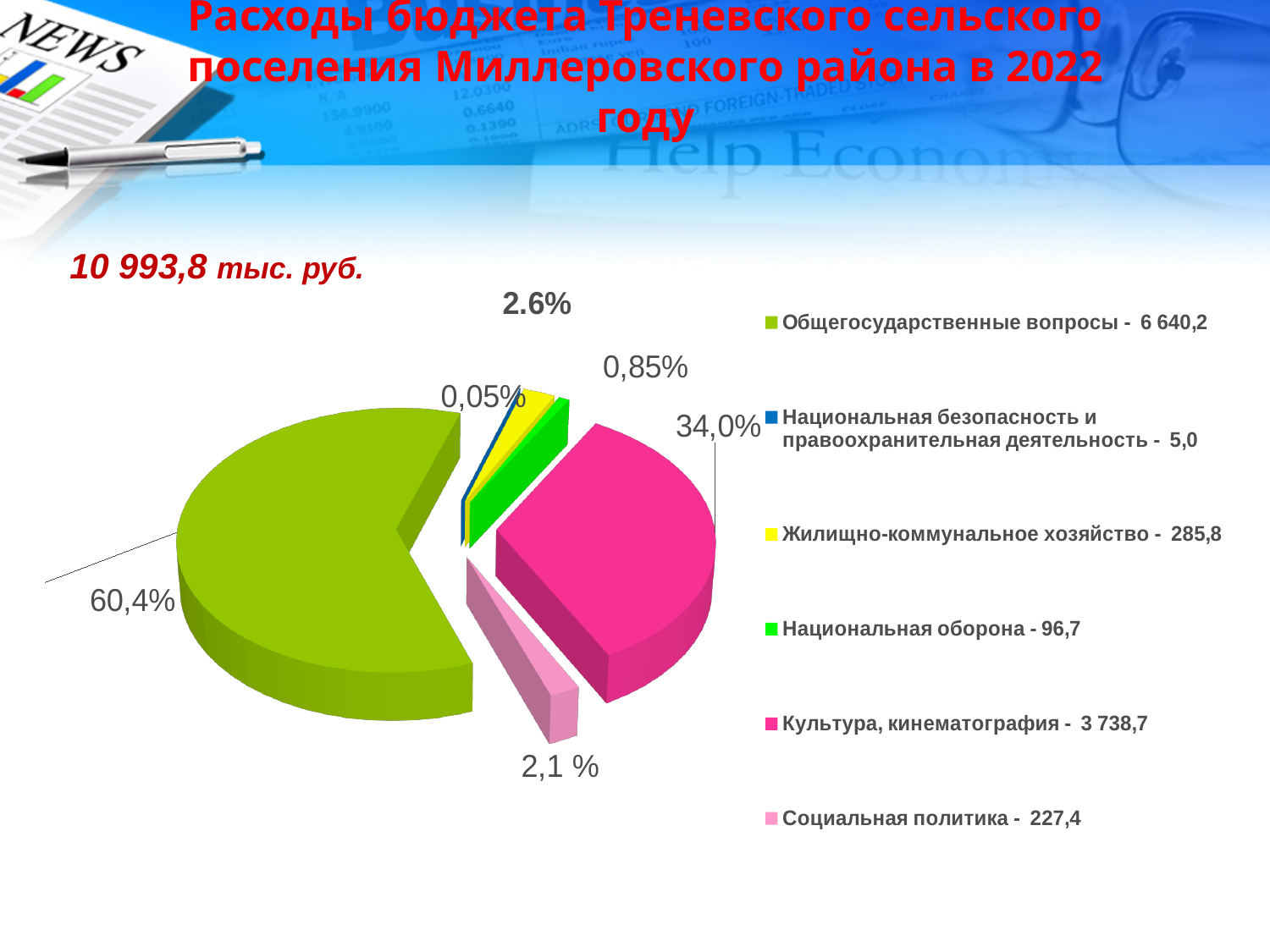
Which is larger: Социальная политика or Жилищно-коммунальное хозяйство? Жилищно-коммунальное хозяйство How many categories does the legend of the pie chart list? 6 What is the value shown in the legend for Национальная оборона? 96,7 Which category has the smallest slice of the pie? Национальная безопасность и правоохранительная деятельность What share of the pie does Общегосударственные вопросы take? 60,4% What share of the pie does Культура, кинематография take? 34,0% What is the value shown in the legend for Жилищно-коммунальное хозяйство? 285,8 Which category has the largest slice of the pie? Общегосударственные вопросы What is the value shown in the legend for Культура, кинематография? 3 738,7 What is the difference between the legend values for Общегосударственные вопросы and Культура, кинематография? 2 901,5 What kind of chart is shown on the slide? pie chart What is the value shown in the legend for Общегосударственные вопросы? 6 640,2